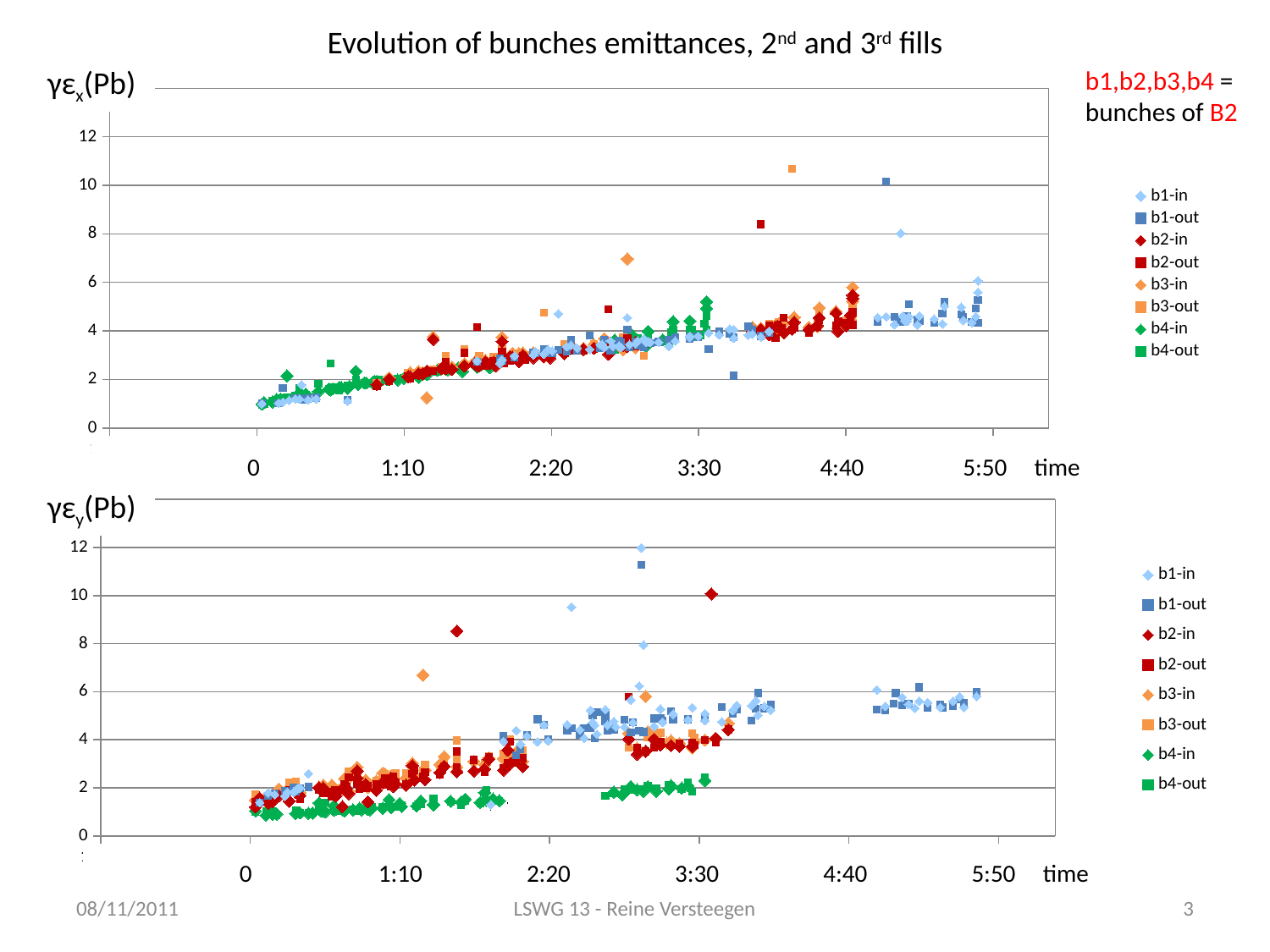
In the bottom chart (γεy(Pb)), do the b1-in values generally rise or fall as time increases? rise How many series does the legend of the bottom chart (γεy(Pb)) list? 8 In the top chart (γεx(Pb)), do the emittance values generally rise or fall as time increases? rise In the bottom chart (γεy(Pb)), are the b1-in values near 5:50 greater or less than 4? greater What is the title shown above the charts on the slide? Evolution of bunches emittances, 2nd and 3rd fills In the bottom chart (γεy(Pb)), around 3:30, which series has larger values: b1-in or b4-out? b1-in In the top chart (γεx(Pb)), are the values at time 0 greater or less than 2? less How many series does the legend of the top chart (γεx(Pb)) list? 8 What kind of chart is the top chart (γεx(Pb))? scatter chart In the bottom chart (γεy(Pb)), are the b4-out values around 3:30 greater or less than 4? less What are the legend entries of the top chart (γεx(Pb))? b1-in, b1-out, b2-in, b2-out, b3-in, b3-out, b4-in, b4-out